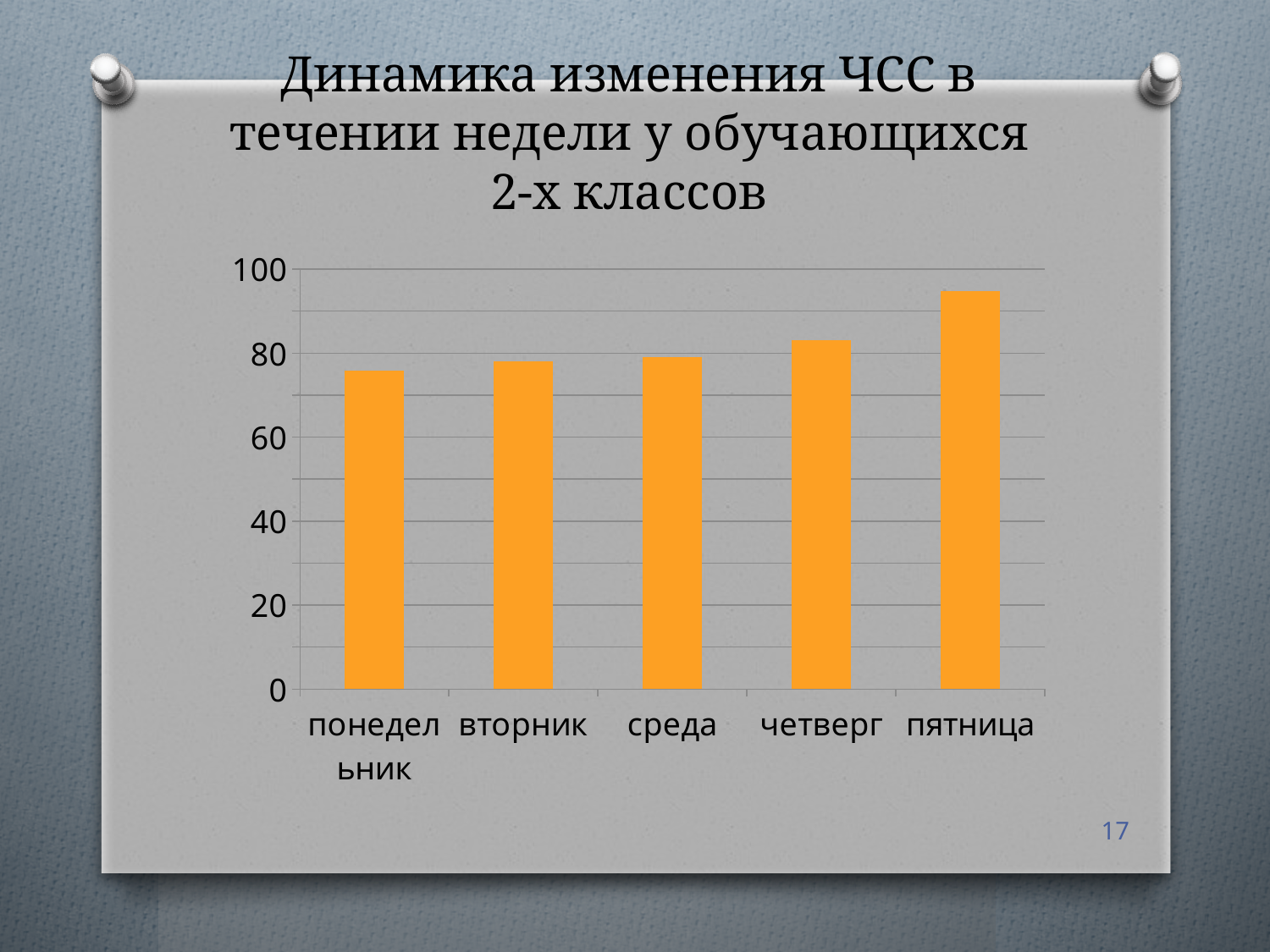
What colour are the bars in the chart? orange How many categories (days) are shown on the x axis of the chart? 5 Is the value for понедельник greater or less than 80? less Is the value for пятница greater or less than 80? greater Which is larger, the value for пятница or the value for понедельник? пятница Do the values rise or fall from понедельник to пятница? rise Is the value for четверг greater or less than 80? greater Which day has the highest value in the chart? пятница Which is larger, the value for четверг or the value for вторник? четверг Which day has the lowest value in the chart? понедельник What kind of chart is shown on the slide? bar chart